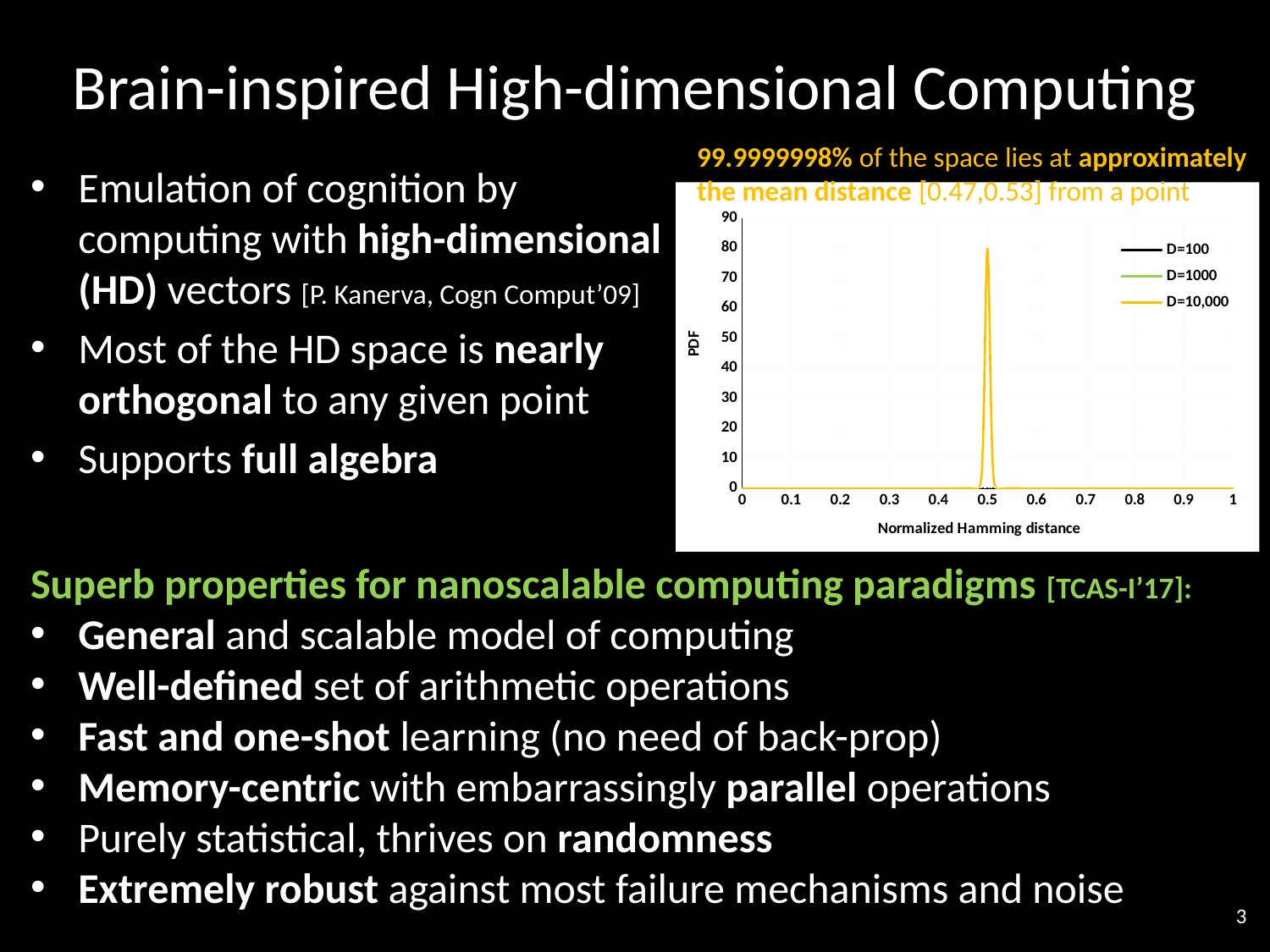
What is the x-axis title of the chart? Normalized Hamming distance Is the PDF value of the D=10,000 curve at a normalized Hamming distance of 0.2 greater or less than 10? less Which series has a lower peak, D=100 or D=10,000? D=100 At what normalized Hamming distance does the D=10,000 curve reach its peak? 0.5 Is the peak PDF value of the D=10,000 curve greater or less than 90? less Which series has the highest peak in the chart? D=10,000 Does the D=10,000 curve rise or fall between normalized Hamming distances of 0.5 and 0.6? fall What are the series names listed in the chart legend? D=100, D=1000, D=10,000 How many tick labels are shown on the x axis of the chart? 11 Is the peak PDF value of the D=10,000 curve greater or less than 70? greater How many series does the chart legend list? 3 What kind of chart is shown on the slide? line chart